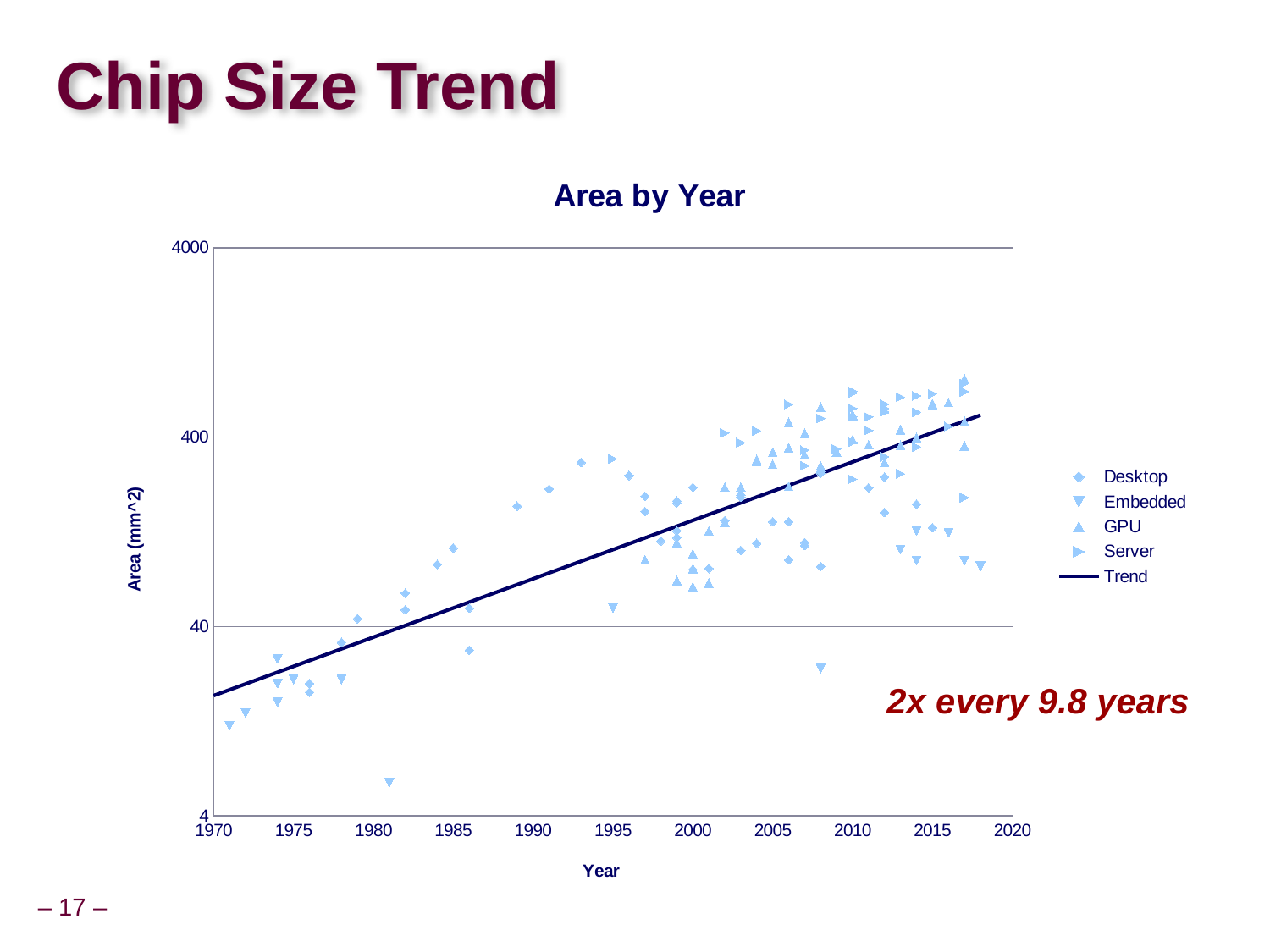
Is the Embedded point plotted near 1981 greater or less than 40? less Which legend entry is drawn as a solid line rather than markers? Trend What kind of chart is shown on the slide? Scatter chart Is the value of the Trend line at 1970 greater or less than 40? less What is the highest tick value shown on the vertical axis? 4000 Is the Embedded point plotted near 2008 greater or less than 40? less How many entries does the chart's legend list? 5 What is the label of the vertical axis? Area (mm^2) Does the Trend line rise or fall as the year increases? Rise